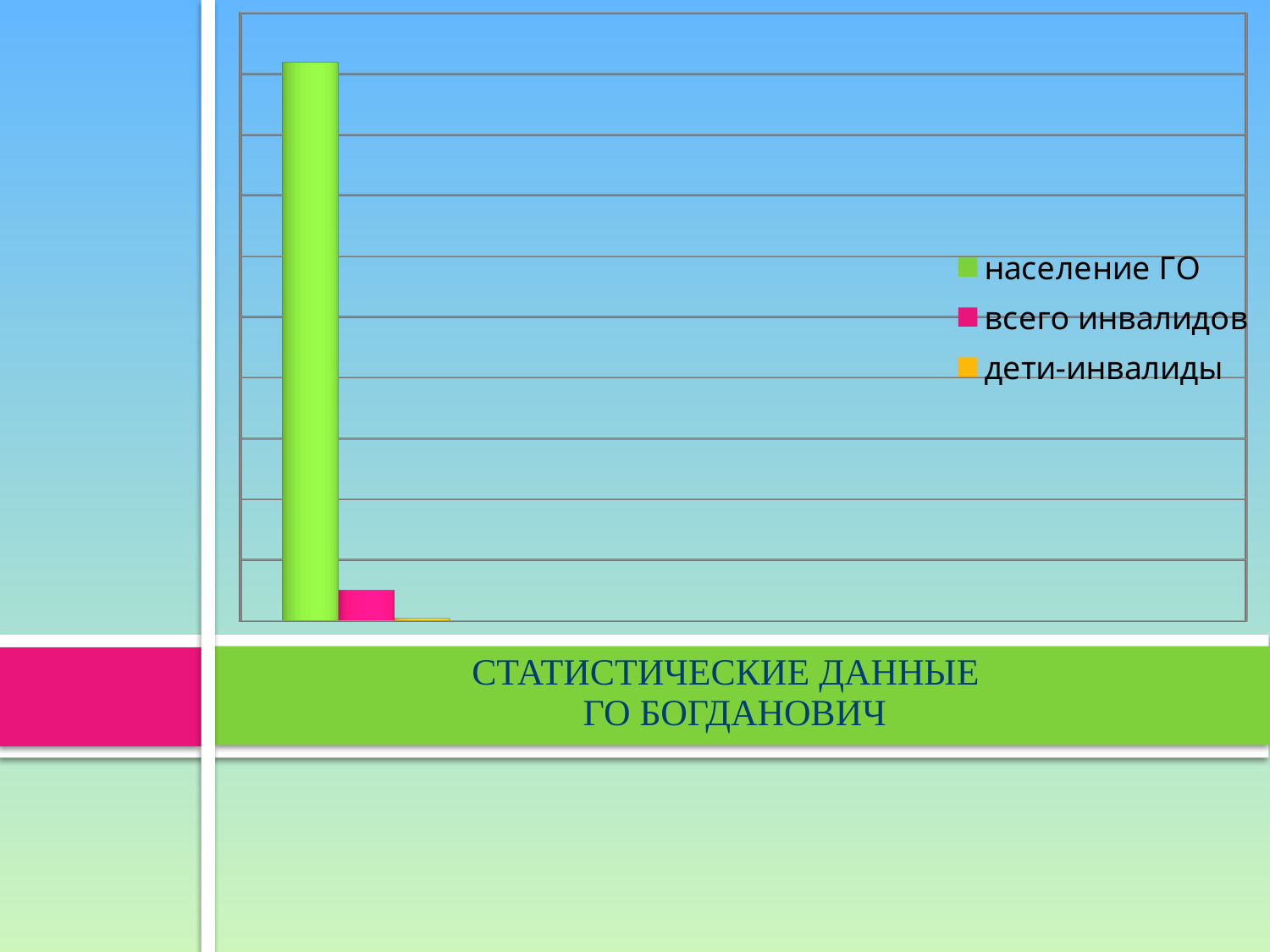
What kind of chart is shown on the slide? bar chart Which bar is taller: всего инвалидов or дети-инвалиды? всего инвалидов Which bar is taller: население ГО or всего инвалидов? население ГО Which series has the shortest bar in the chart? дети-инвалиды How many series does the chart legend list? 3 Which series is shown in green in the legend? население ГО What colour is the bar for всего инвалидов? pink Which series has the tallest bar in the chart? население ГО